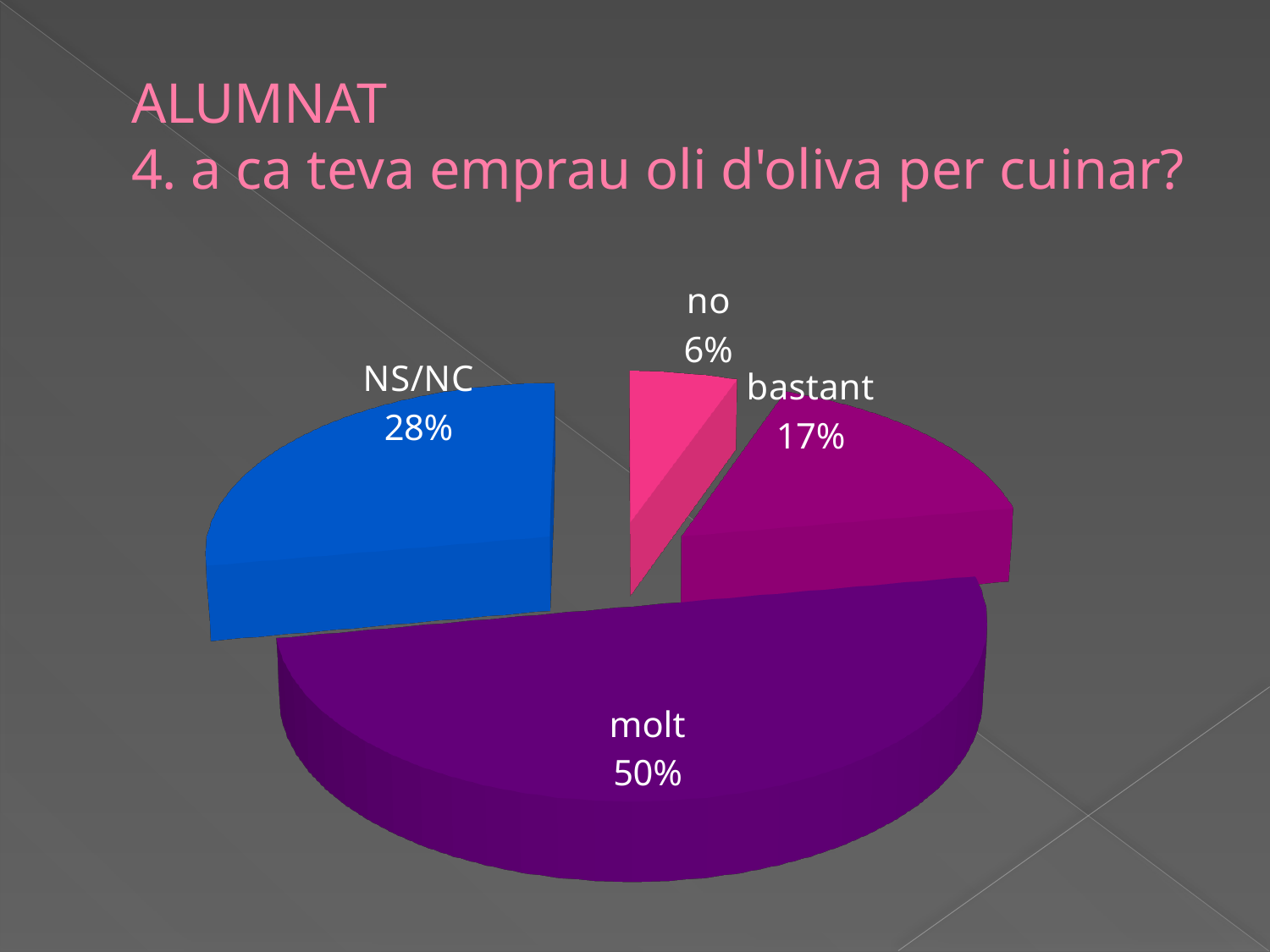
What kind of chart is shown on the slide? pie chart What is the difference in percentage points between the "molt" and "NS/NC" slices? 22 How many slices does the pie chart have? 4 What percentage is shown for the "no" slice? 6% Which category has the largest slice of the pie? molt Which category has the smallest slice of the pie? no What colour is the "NS/NC" slice? blue What is the difference in percentage points between the "bastant" and "no" slices? 11 Which slice is larger, "NS/NC" or "bastant"? NS/NC What share of the pie does the "molt" slice represent? 50% What percentage is shown for the "NS/NC" slice? 28% What percentage is shown for the "bastant" slice? 17%